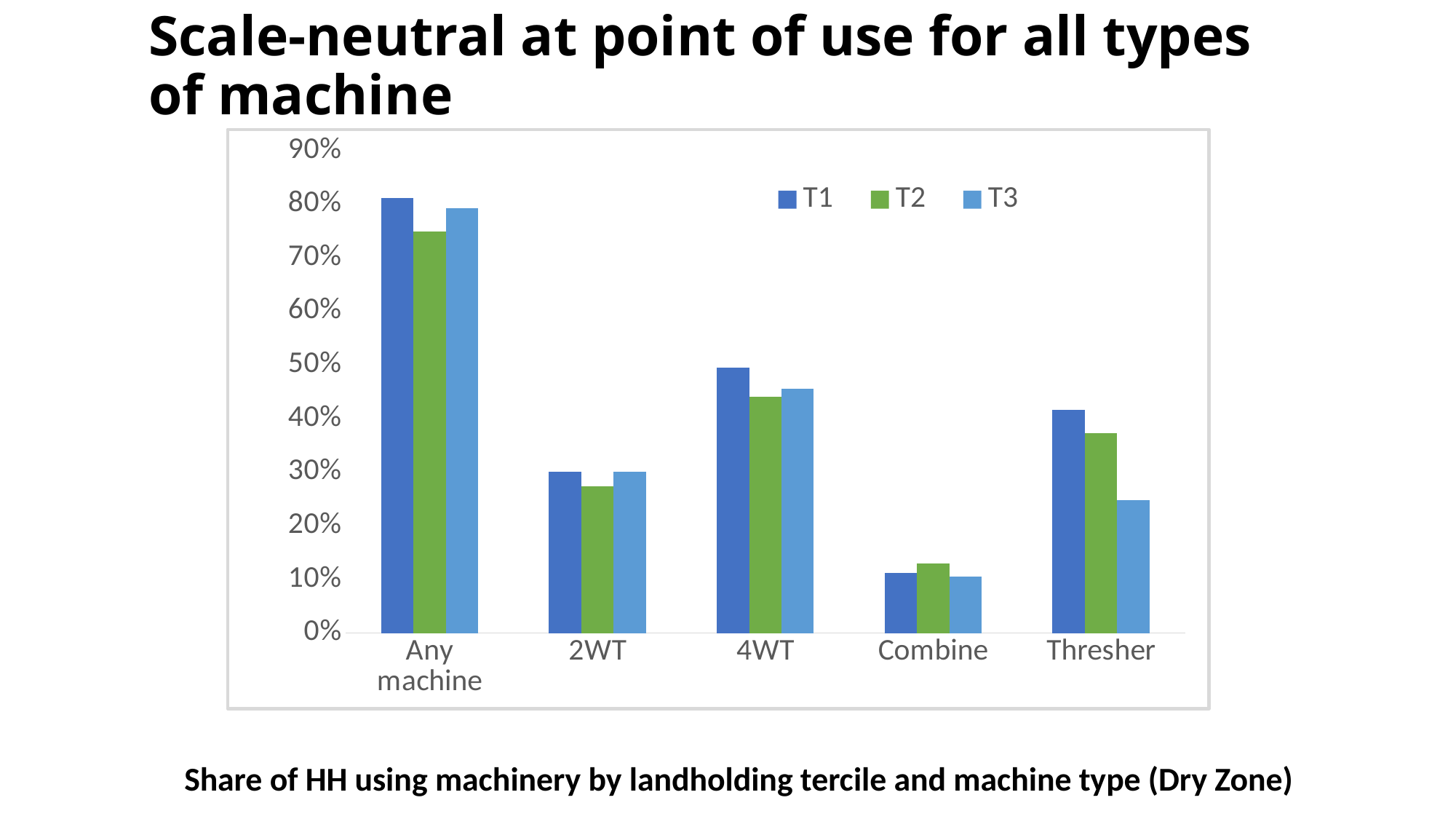
For Thresher, which is larger: the T1 value or the T3 value? T1 Which category has the highest T1 value? Any machine How many series does the legend list? 3 What kind of chart is shown on the slide? bar chart For Any machine, which is larger: the T2 value or the T3 value? T3 Which category has the lowest T1 value? Combine Is the T1 value for Any machine greater or less than 70%? greater Is the T1 value for Combine greater or less than 20%? less What are the three series names listed in the legend? T1, T2, T3 Is the T2 value for 4WT greater or less than 40%? greater How many machine-type categories are shown on the x axis? 5